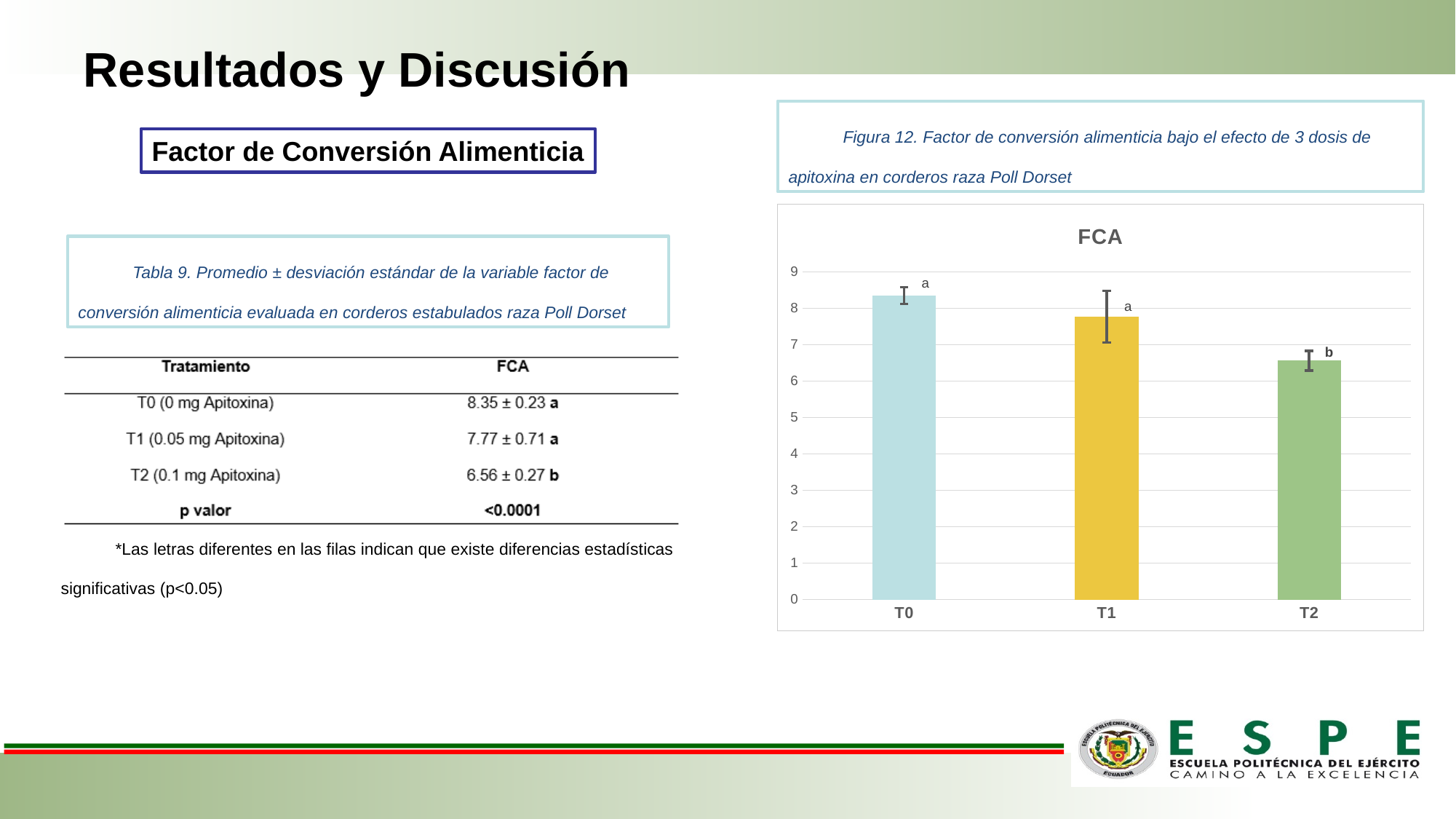
Do the bar values in the FCA chart rise or fall from T0 to T2? fall Which treatment has the highest bar in the FCA chart? T0 In the FCA chart, is the bar for T1 greater or less than 8? less What letter is printed above the T2 bar in the FCA chart? b In the FCA chart, is the bar for T2 greater or less than 7? less How many bars are plotted in the FCA chart? 3 In the FCA chart, is the bar for T2 greater or less than 6? greater What is the title of the chart on the right side of the slide? FCA What kind of chart is shown under the title FCA? bar chart Which treatment has the lowest bar in the FCA chart? T2 In the FCA chart, which bar is taller, T1 or T2? T1